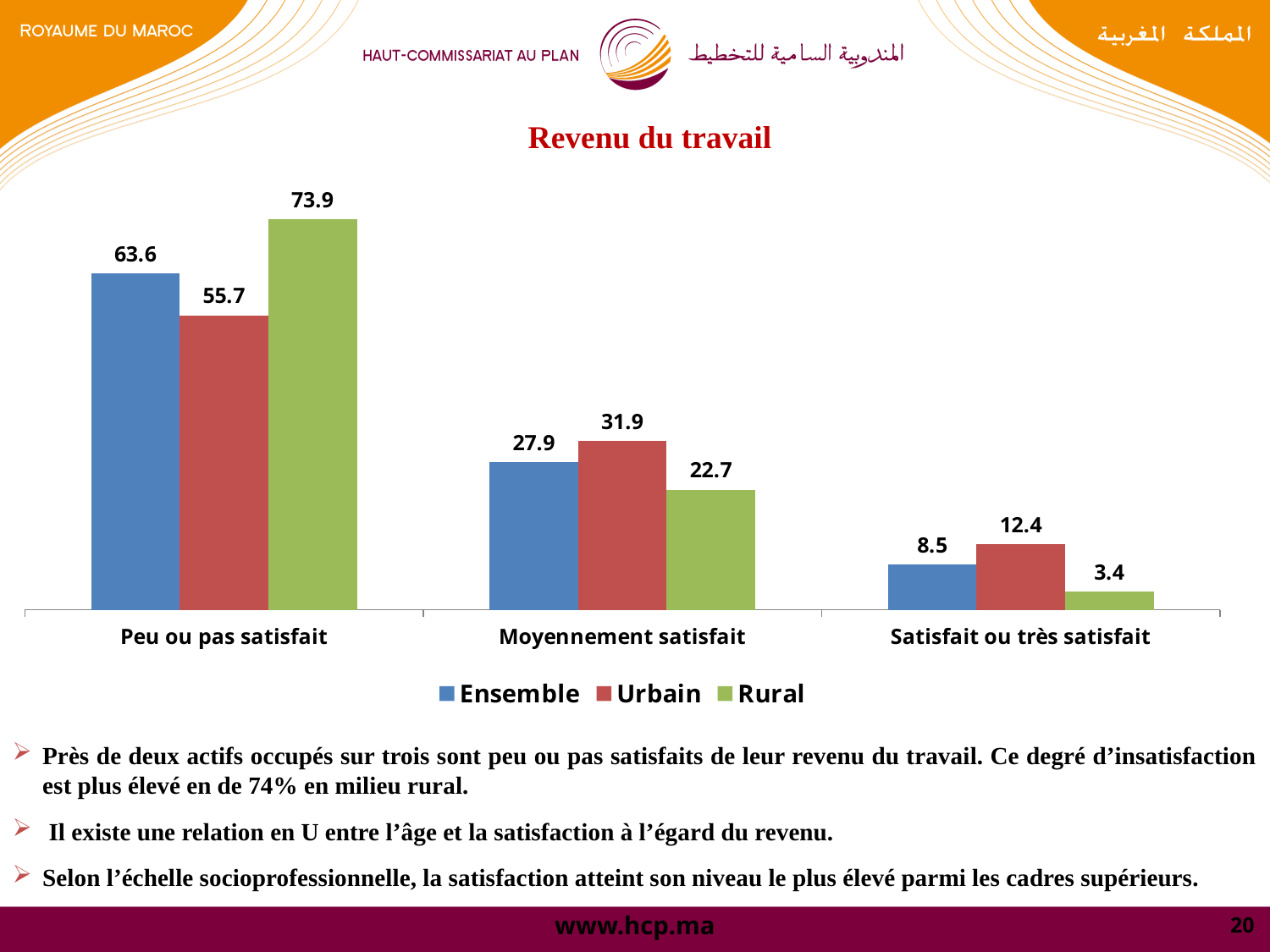
How many series does the legend list? 3 What is the difference between the Rural and Urbain values for "Peu ou pas satisfait"? 18.2 Which series has the lowest value for "Satisfait ou très satisfait"? Rural What is the difference between the Urbain and Rural values for "Moyennement satisfait"? 9.2 What is the Urbain value for "Moyennement satisfait"? 31.9 What kind of chart is shown on the slide? Bar chart What is the Ensemble value for "Satisfait ou très satisfait"? 8.5 How many categories are shown on the x axis? 3 Which is larger for "Moyennement satisfait": the Ensemble value or the Urbain value? Urbain What is the Rural value for "Peu ou pas satisfait"? 73.9 What is the title of the chart? Revenu du travail Which category has the highest Ensemble value? Peu ou pas satisfait